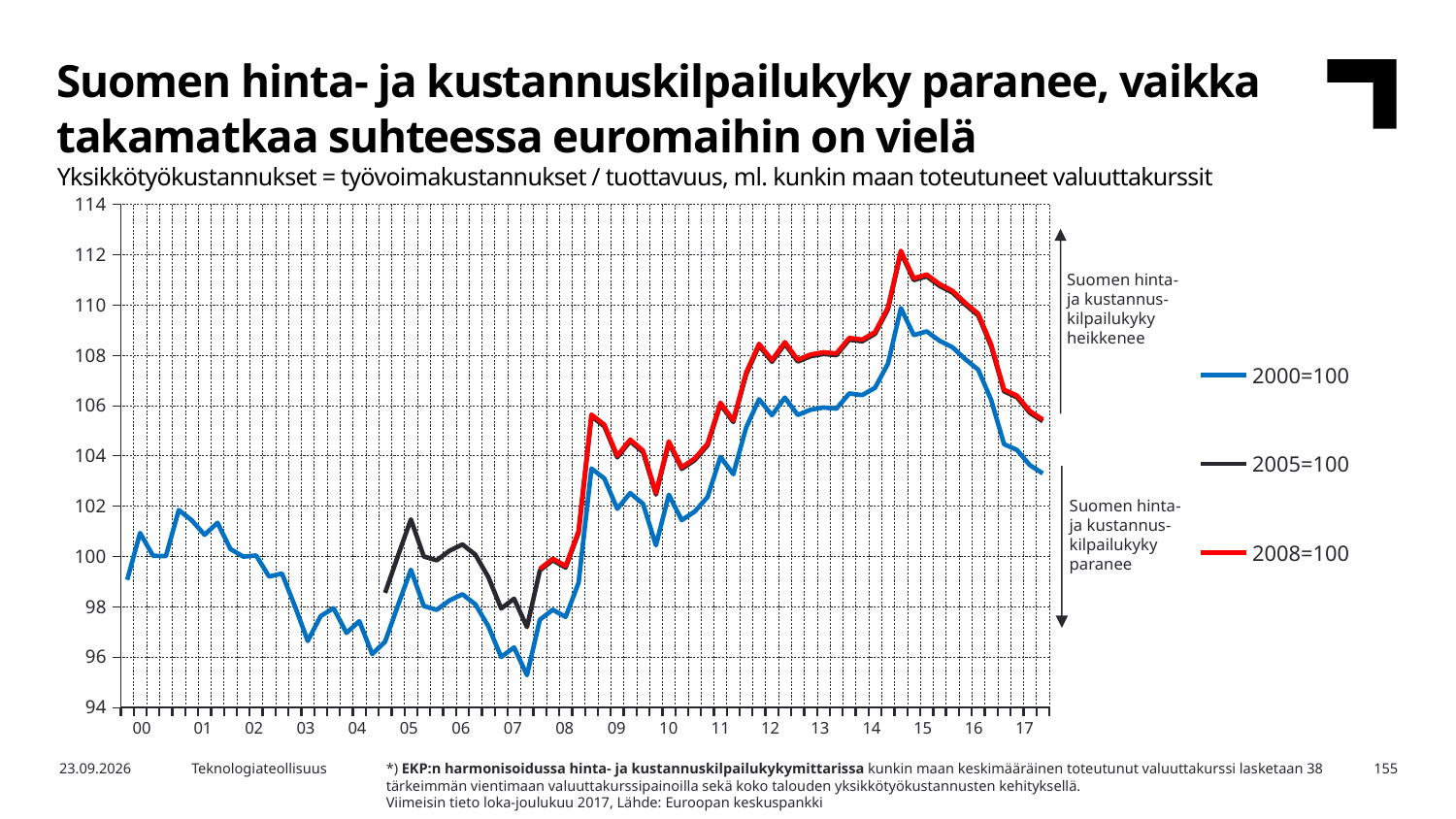
Does the 2000=100 series rise or fall between 2015 and 2017? fall How many series does the legend list? 3 Which series reaches the highest value on the chart? 2008=100 What colour is the line for the 2008=100 series? red At the end of 2017, which series has the higher value, 2000=100 or 2008=100? 2008=100 What are the three series named in the legend? 2000=100, 2005=100, 2008=100 Is the peak value of the 2000=100 series around 2015 greater or less than 108? greater Is the final value of the 2000=100 series at the end of 2017 greater or less than 104? less Is the peak value of the 2008=100 series around 2015 greater or less than 110? greater How many year labels are shown along the x axis? 18 What kind of chart is shown on the slide? line chart